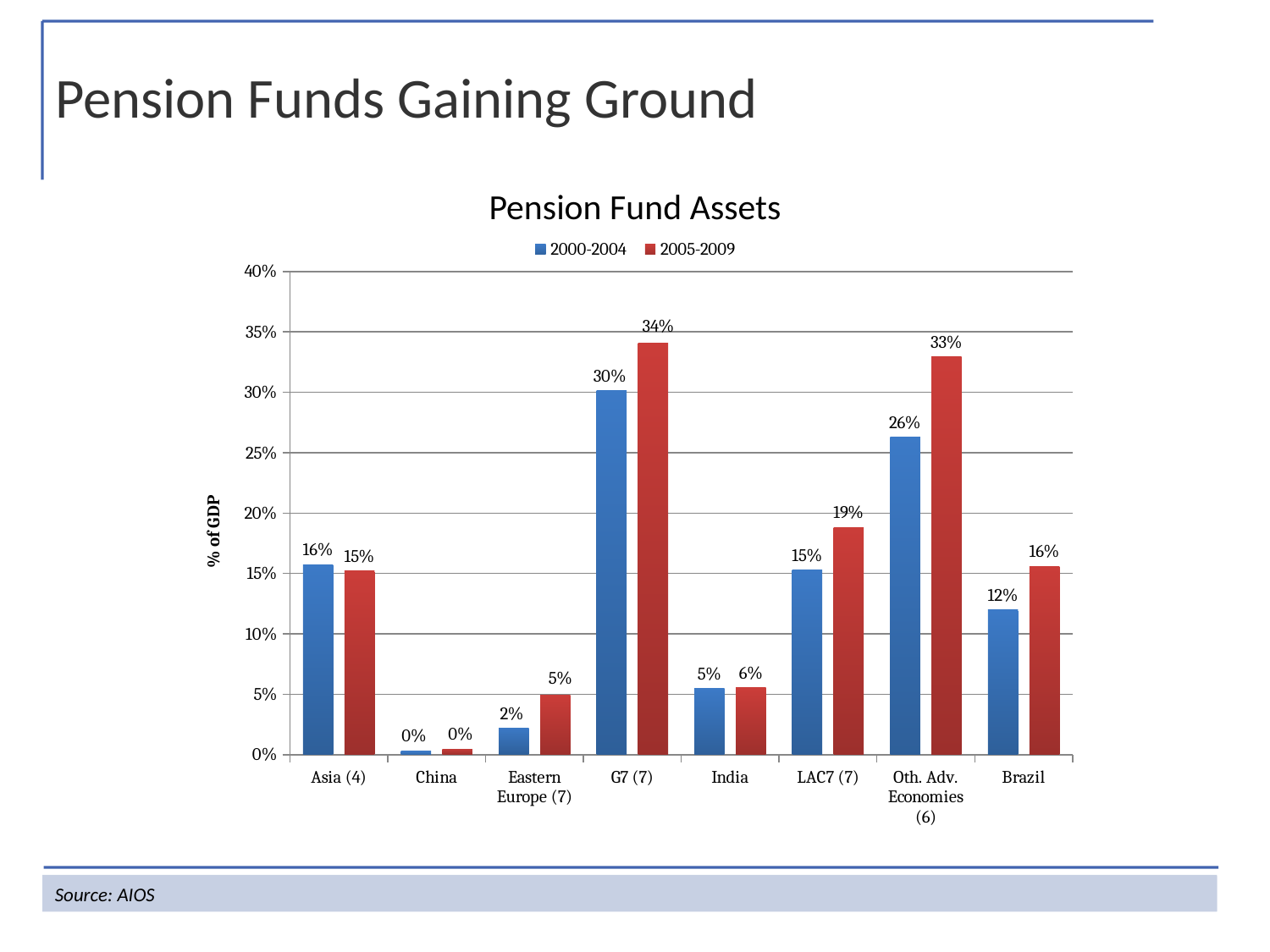
What is the value for Brazil in the 2000-2004 series? 12% What kind of chart is shown on the slide? bar chart How many categories are shown on the x axis? 8 Which is larger for LAC7 (7): the 2000-2004 value or the 2005-2009 value? 2005-2009 What is the value for Eastern Europe (7) in the 2005-2009 series? 5% Which category has the highest value in the 2005-2009 series? G7 (7) How many series does the legend list? 2 Is the 2000-2004 value for G7 (7) greater or less than 25%? greater What is the title of the chart? Pension Fund Assets Which category has the lowest value in the 2000-2004 series? China What is the difference between the 2005-2009 and 2000-2004 values for Oth. Adv. Economies (6)? 7% What is the value for G7 (7) in the 2005-2009 series? 34%